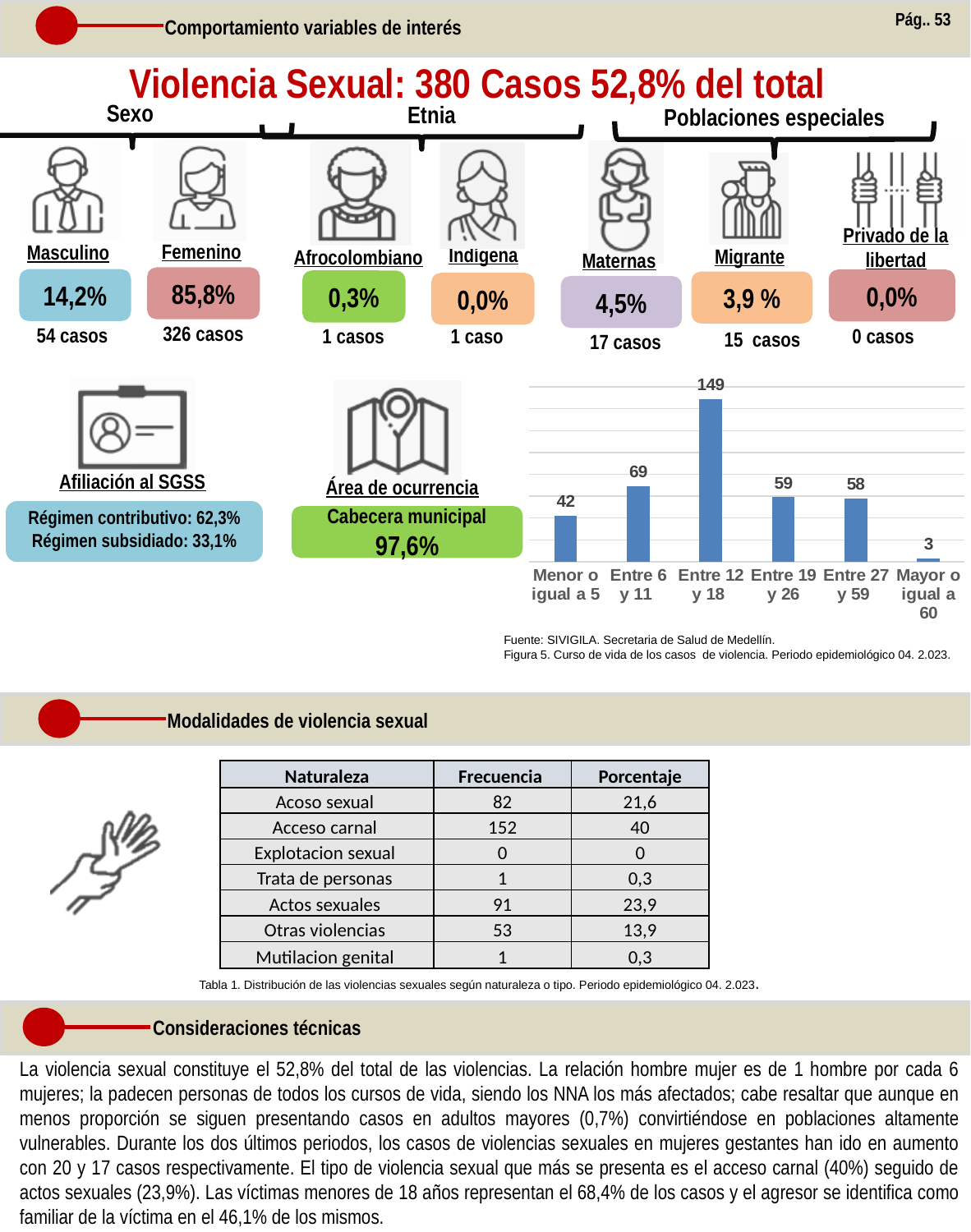
Do the values in the bar chart rise or fall from 'Entre 12 y 18' to 'Mayor o igual a 60'? fall According to the caption, what figure number is the bar chart? Figura 5 Which age group has the highest value in the bar chart? Entre 12 y 18 What is the value for the 'Mayor o igual a 60' age group in the bar chart? 3 Which is larger in the bar chart: the value for 'Entre 6 y 11' or the value for 'Entre 19 y 26'? Entre 6 y 11 How many age-group categories does the bar chart show? 6 What is the value for the 'Menor o igual a 5' age group in the bar chart? 42 What is the value for the 'Entre 12 y 18' age group in the bar chart? 149 What is the value for the 'Entre 27 y 59' age group in the bar chart? 58 What type of chart is shown on the slide? bar chart What is the difference between the values for 'Entre 12 y 18' and 'Entre 6 y 11' in the bar chart? 80 Which age group has the lowest value in the bar chart? Mayor o igual a 60